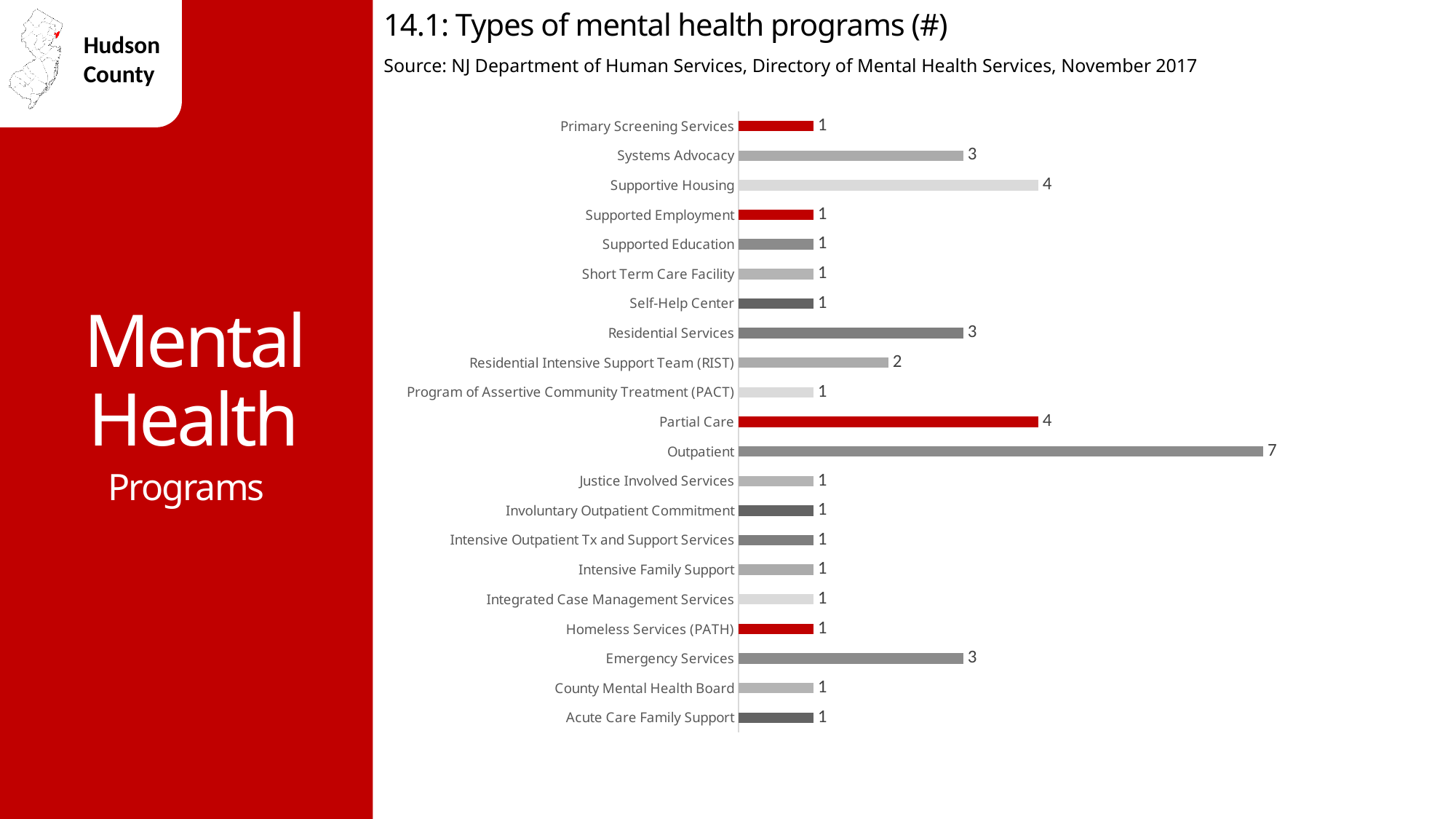
What is the difference between the values for Systems Advocacy and Residential Intensive Support Team (RIST)? 1 How many categories are shown in the chart? 21 What is the value for Partial Care? 4 What is the value for Residential Intensive Support Team (RIST)? 2 What is the title of the chart? 14.1: Types of mental health programs (#) What is the value for Outpatient? 7 Which category has the highest value? Outpatient What is the value for Emergency Services? 3 What kind of chart is shown on the slide? Bar chart Which is larger, the value for Residential Services or the value for Supportive Housing? Supportive Housing What is the value for Supportive Housing? 4 What is the difference between the values for Outpatient and Partial Care? 3